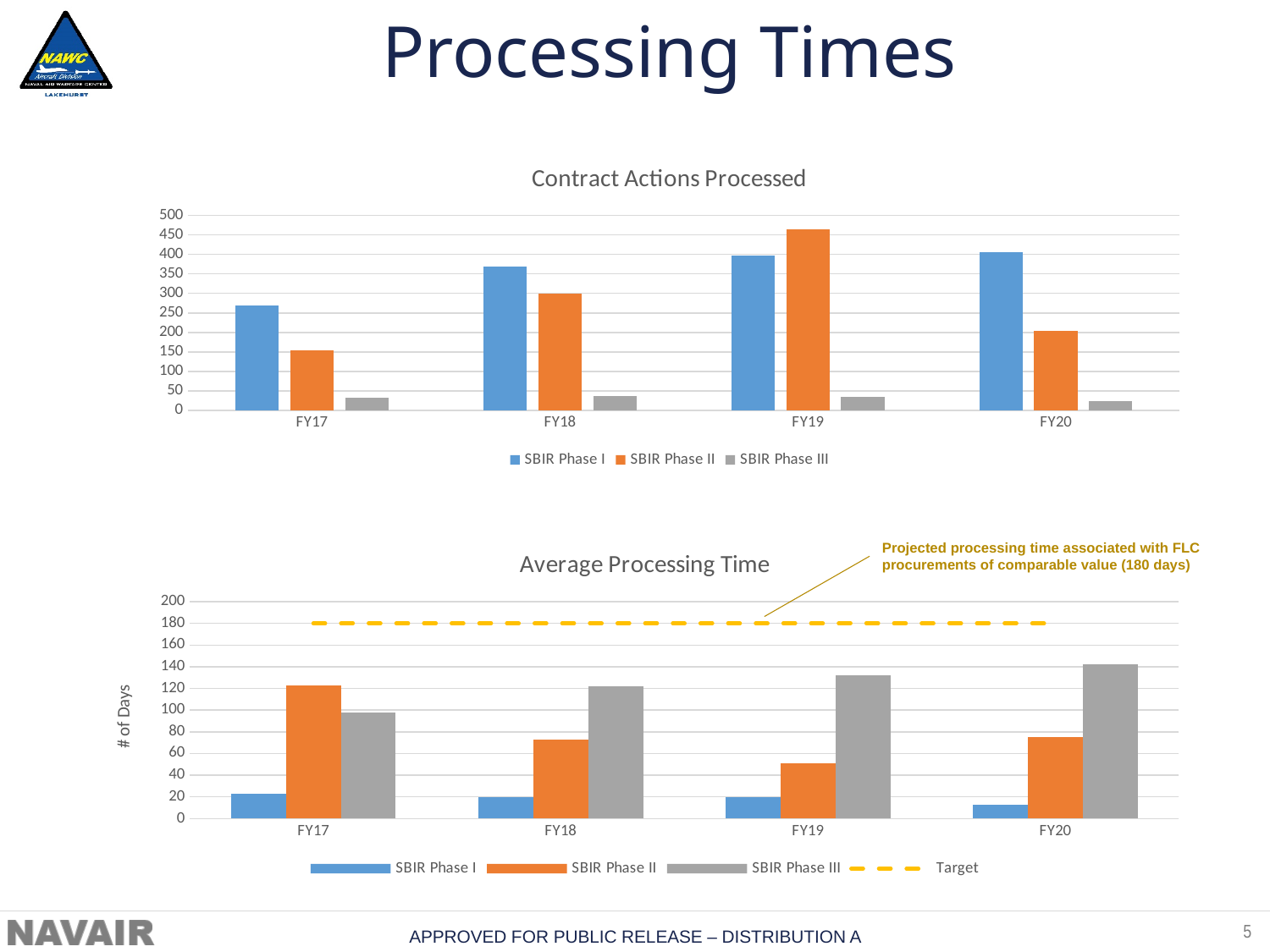
In the 'Average Processing Time' chart, do the SBIR Phase III values rise or fall from FY17 to FY20? rise How many fiscal years are shown on the x axis of the 'Contract Actions Processed' chart? 4 In the 'Contract Actions Processed' chart, is the SBIR Phase II value for FY19 greater or less than 400? greater In the 'Contract Actions Processed' chart, is the SBIR Phase I value for FY17 greater or less than 300? less What kind of chart is the 'Contract Actions Processed' chart? bar chart In the 'Average Processing Time' chart, which fiscal year has the highest SBIR Phase III value? FY20 In the 'Contract Actions Processed' chart, which series has the lowest value in FY18? SBIR Phase III In the 'Average Processing Time' chart, is the SBIR Phase II value for FY17 greater or less than 100? greater How many entries does the legend of the 'Average Processing Time' chart list? 4 In the 'Contract Actions Processed' chart, which fiscal year has the highest SBIR Phase II value? FY19 In the 'Average Processing Time' chart, what is the Target value in days shown by the dashed line? 180 How many series does the legend of the 'Contract Actions Processed' chart list? 3